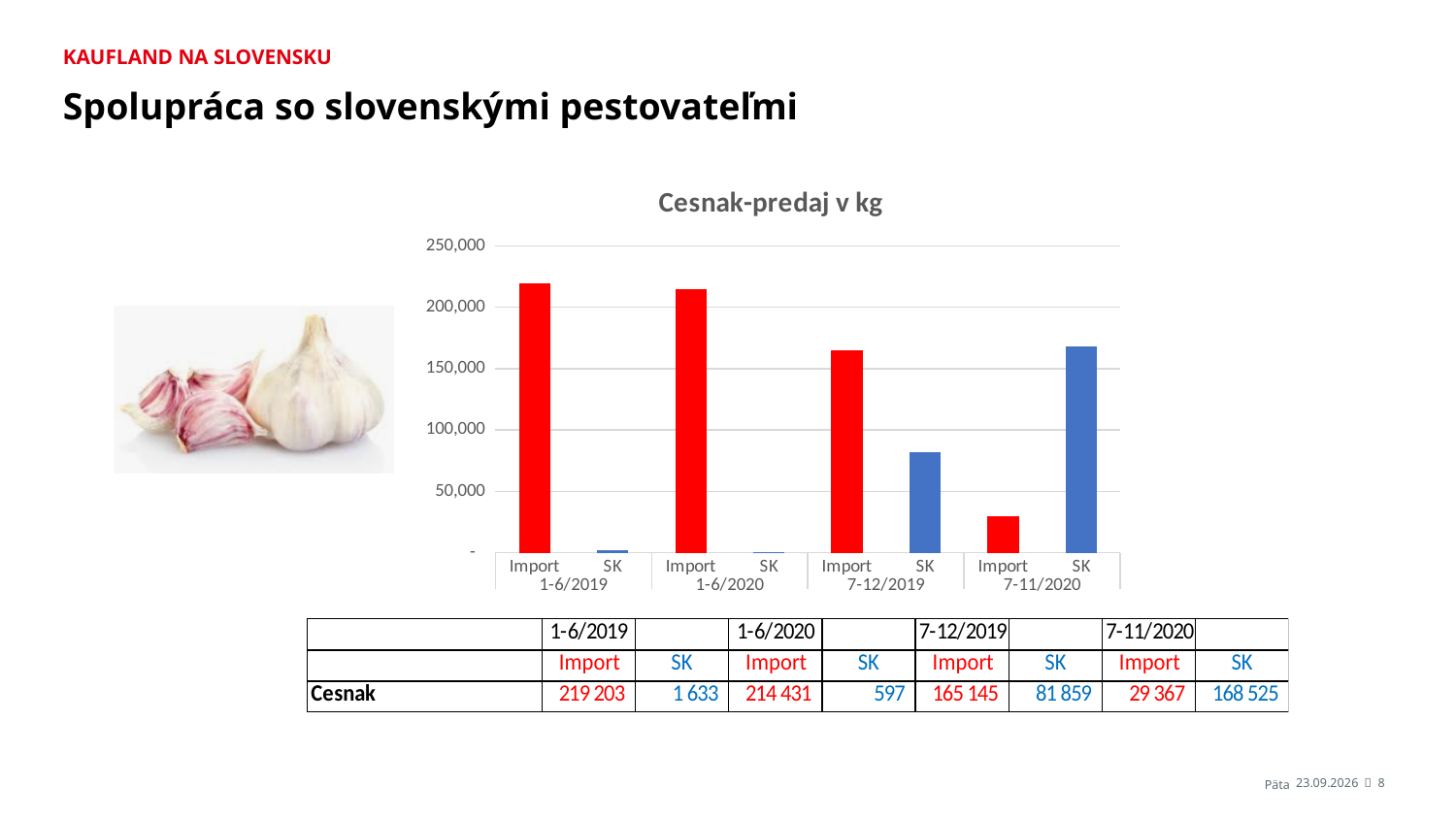
What is the Import value for 7-12/2019? 165 145 Is the SK value for 7-12/2019 greater or less than 100,000? less Which is larger, the SK value for 7-12/2019 or the SK value for 7-11/2020? SK 7-11/2020 What kind of chart is shown on the slide? bar chart What is the title of the chart? Cesnak-predaj v kg What is the difference between the Import and SK values for 7-12/2019? 83 286 Which bar has the highest value in the chart? Import 1-6/2019 What is the Import value for 1-6/2019? 219 203 What is the SK value for 7-11/2020? 168 525 What is the difference between the Import and SK values for 7-11/2020? 139 158 What is the SK value for 1-6/2020? 597 Which bar has the lowest value in the chart? SK 1-6/2020